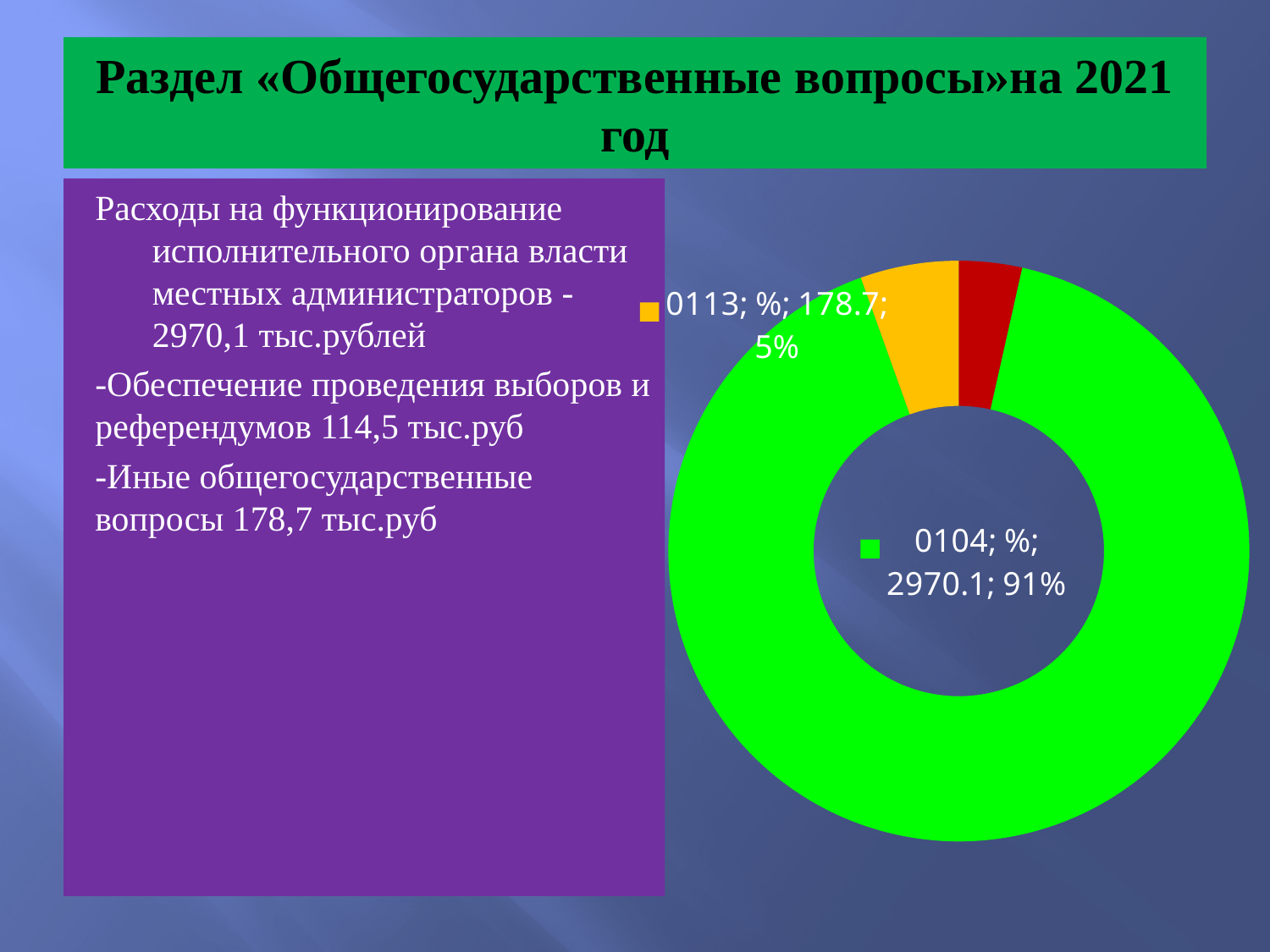
What share of the chart does category 0104 represent? 91% Which category has the largest slice in the chart? 0104 What kind of chart is shown on the slide? doughnut chart What colour is the slice for category 0113? yellow What is the difference between the values for 0104 and 0113? 2791.4 What value is shown for category 0104 in the chart? 2970.1 What colour is the slice for category 0104? green How many slices does the chart have? 3 What share of the chart does category 0113 represent? 5% Which is larger, the value for 0104 or the value for 0113? 0104 What value is shown for category 0113 in the chart? 178.7